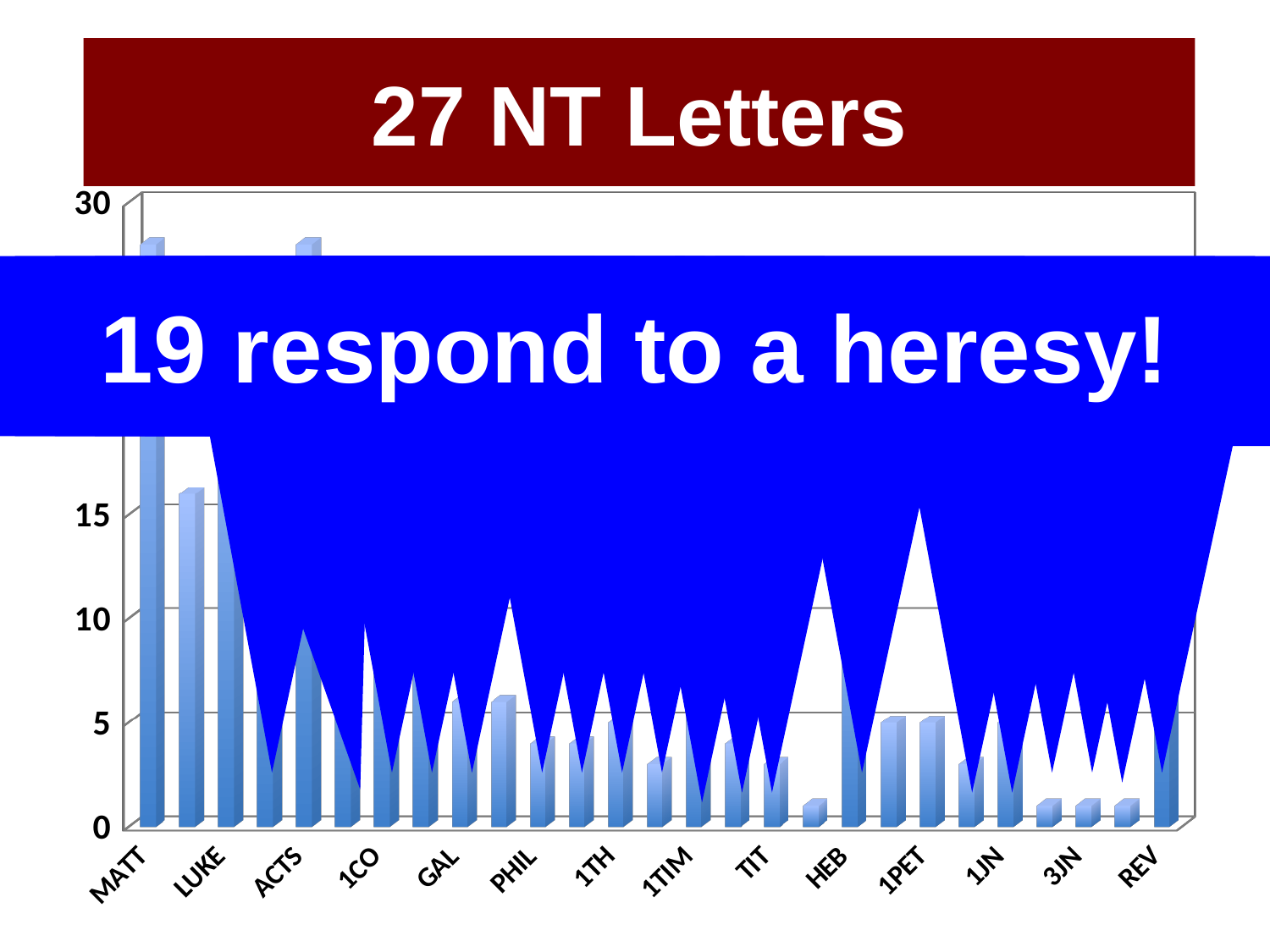
What is the title shown above the chart? 27 NT Letters Is the value for 3JN greater or less than 5? less What kind of chart is shown on the slide? bar chart Is the value for GAL greater or less than 10? less Is the value for HEB greater or less than 10? greater Which is larger, the value for MATT or the value for GAL? MATT Which is larger, the value for HEB or the value for 3JN? HEB How many bars are plotted in the chart? 27